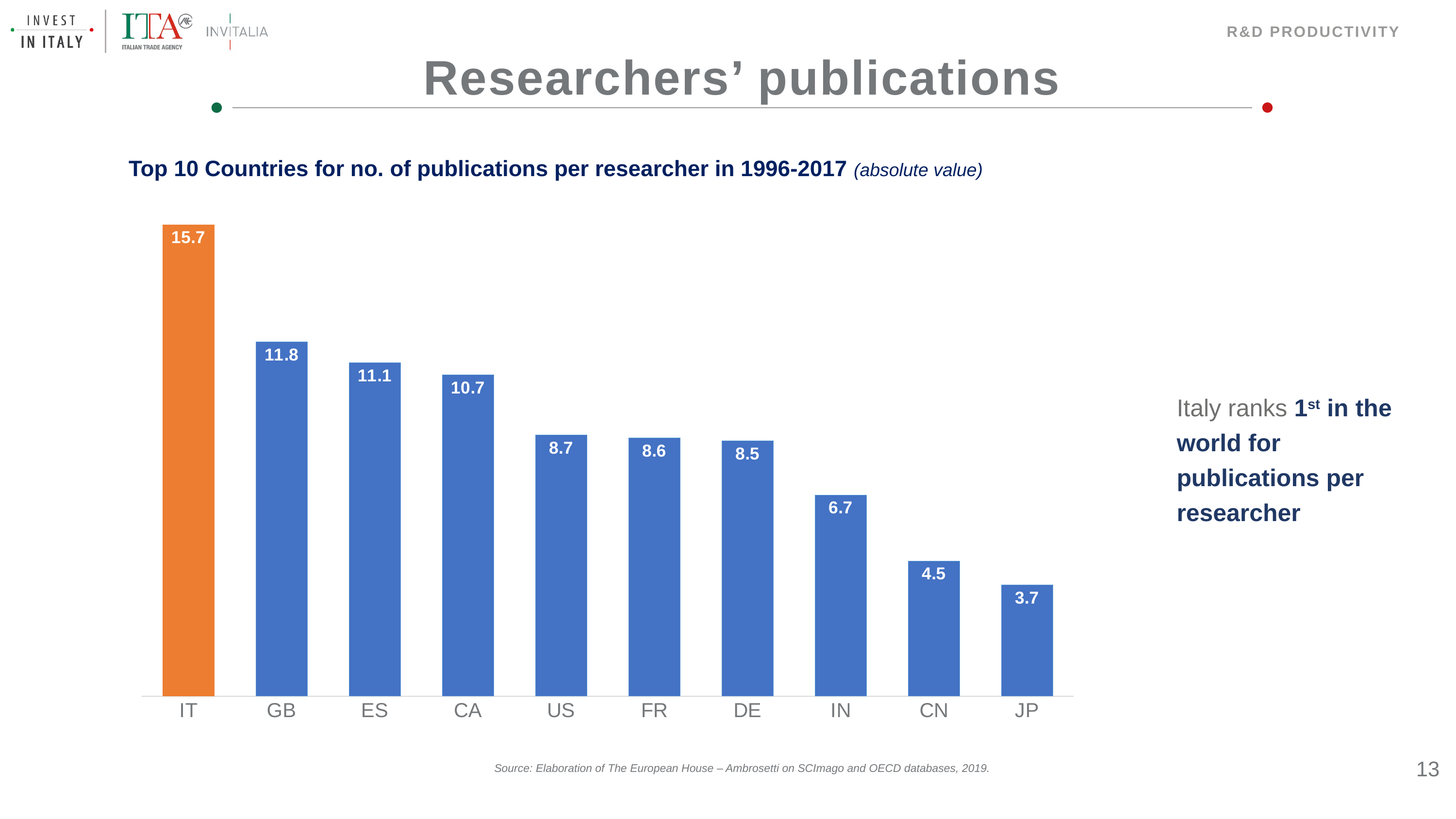
What is the number of publications per researcher for IT? 15.7 Which country's bar is coloured orange instead of blue? IT How many countries are shown in the chart? 10 Which has a higher value, ES or US? ES Which country has the lowest number of publications per researcher? JP Which country has the highest number of publications per researcher? IT What is the value shown for JP? 3.7 What is the difference between the values for IN and CN? 2.2 What kind of chart is shown on the slide? Bar chart What is the value shown for CA? 10.7 Do the values rise or fall from left to right across the countries? Fall What is the difference between the values for IT and GB? 3.9